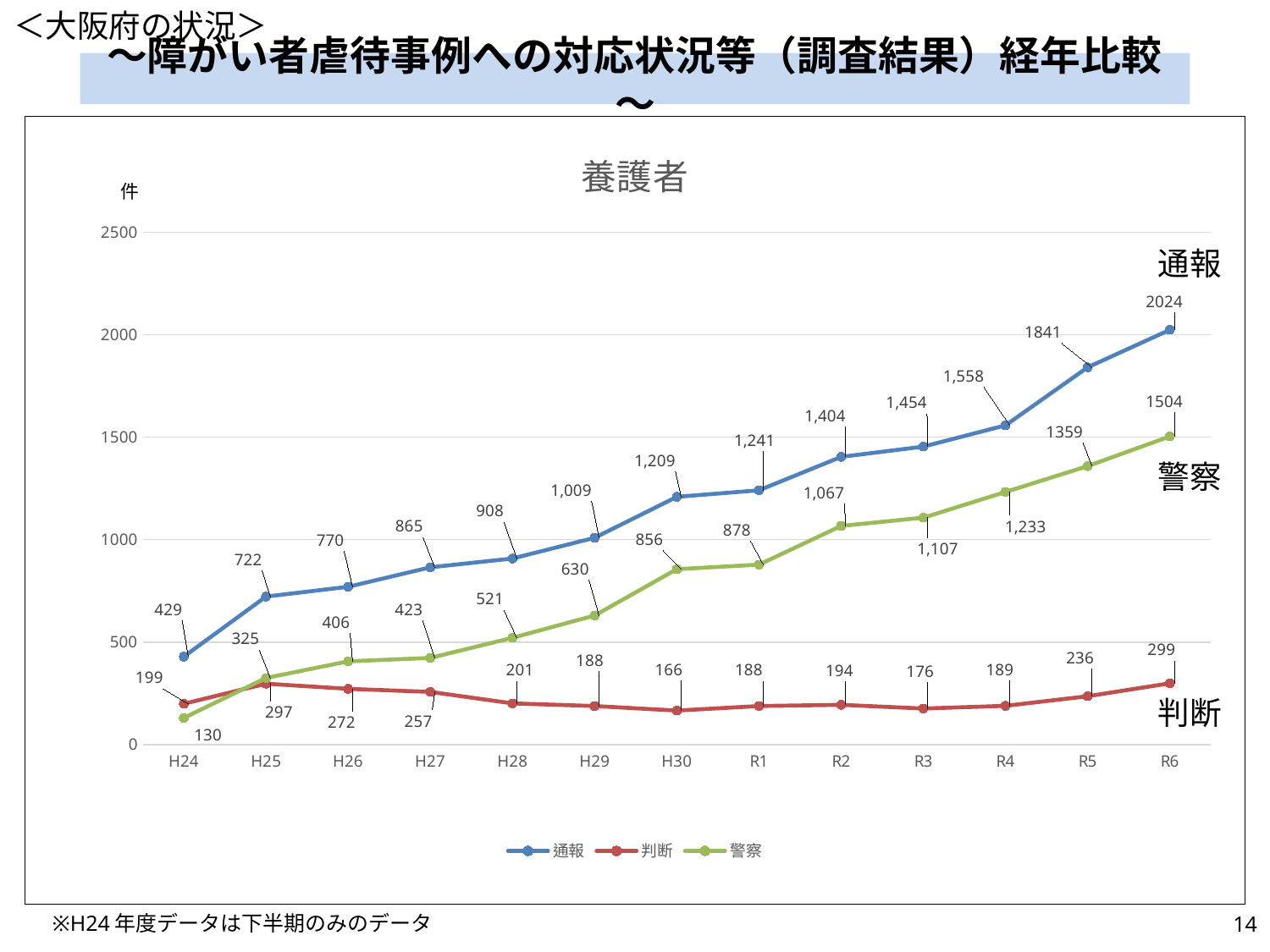
What is the value of 警察 at H30? 856 In which year is 通報 highest? R6 What is the value of 通報 at H29? 1,009 What is the difference between 通報 and 警察 at R6? 520 How many years are shown on the x axis? 13 Which is larger at H24, 通報 or 警察? 通報 What kind of chart is this? line chart What is the value of 判断 at H24? 199 What is the value of 通報 at R6? 2024 In which year is 警察 lowest? H24 Is the value for 通報 at R5 greater or less than 1500? greater How many series does the legend list? 3